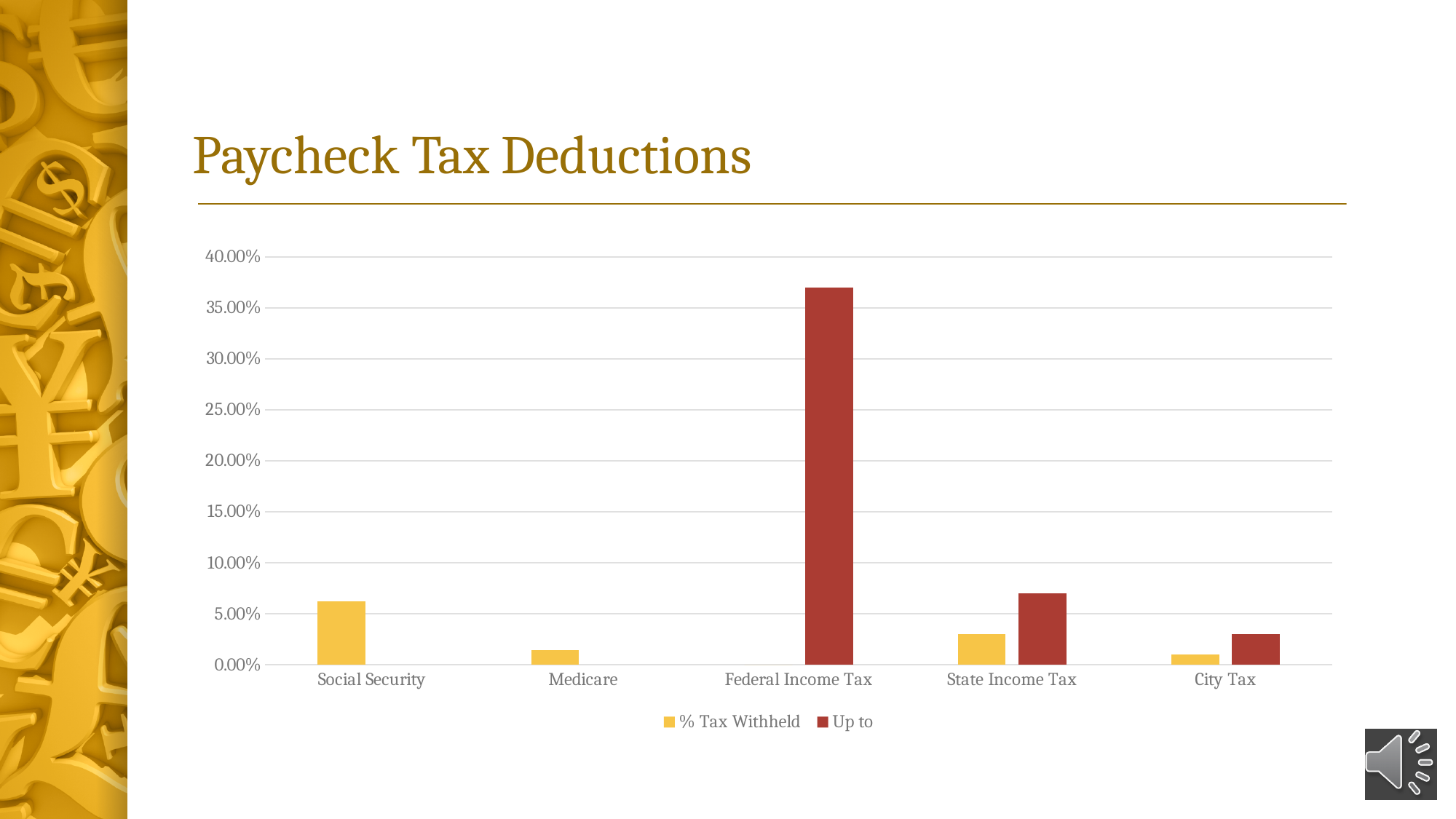
Is the 'Up to' value for State Income Tax greater or less than 10.00%? less How many categories are shown on the x axis of the chart? 5 What are the two series names listed in the chart's legend? % Tax Withheld and Up to Which category has the highest '% Tax Withheld' value? Social Security Which is larger: the 'Up to' value for State Income Tax or the 'Up to' value for City Tax? State Income Tax Is the '% Tax Withheld' value for Social Security greater or less than 5.00%? greater Which category has the tallest bar in the chart? Federal Income Tax What kind of chart is shown on the slide? bar chart Is the 'Up to' value for Federal Income Tax greater or less than 35.00%? greater Which category has the lowest '% Tax Withheld' value? Federal Income Tax Which is larger: the '% Tax Withheld' value for Social Security or for Medicare? Social Security How many series does the chart's legend list? 2